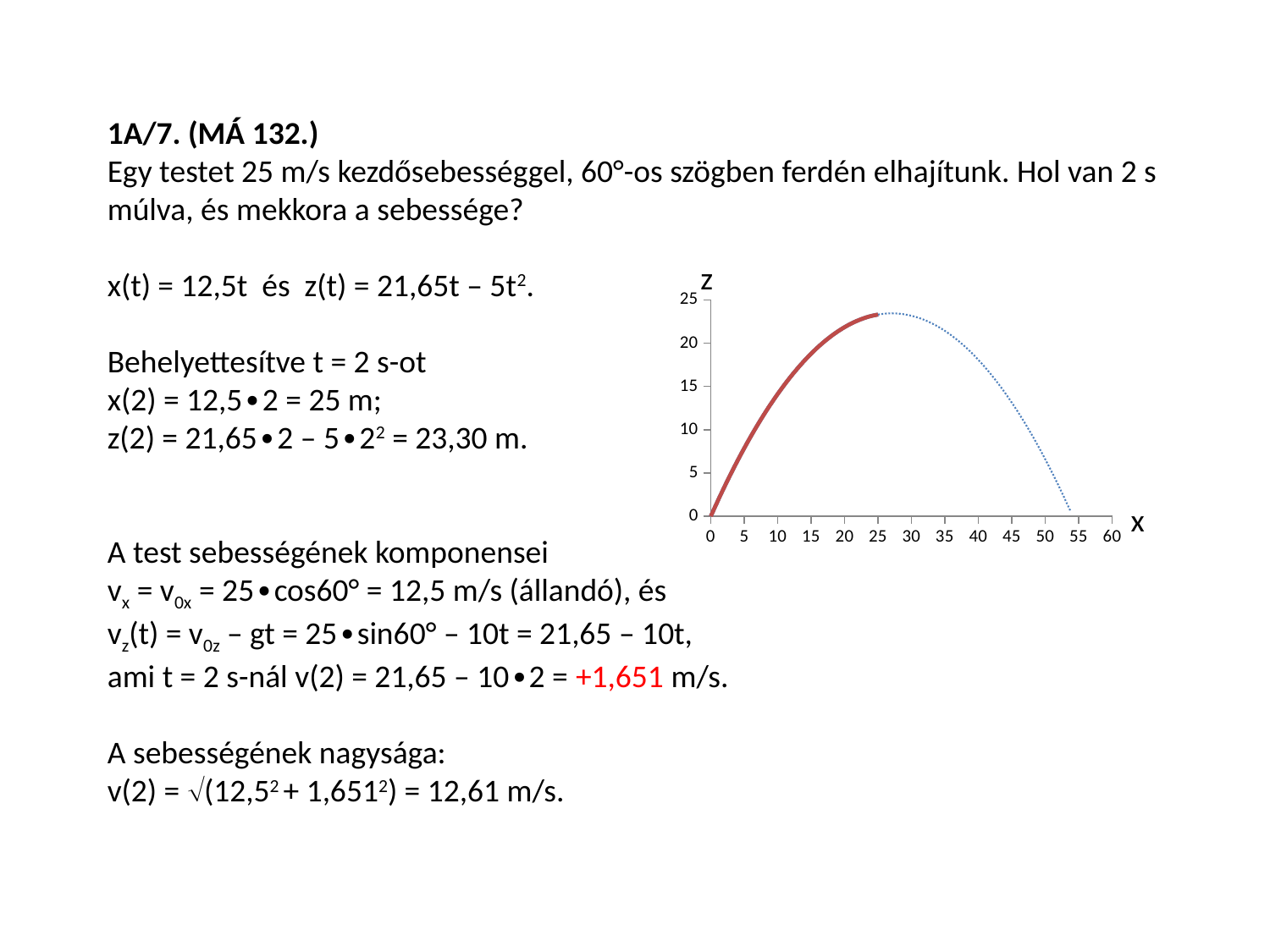
How does z change as x increases from 0 to 25 along the solid red part of the curve? it rises What is the label of the horizontal axis of the chart? x Is the value of z at x = 50 greater or less than 10? less Is the value of z at x = 25 greater or less than 20? greater Is the x value where the dotted curve returns to z = 0 greater or less than 50? greater What is the label of the vertical axis of the chart? z What kind of chart is shown on the slide? line chart What is the highest tick value shown on the horizontal axis? 60 How does z change as x increases from 30 to 55 along the dotted part of the curve? it falls